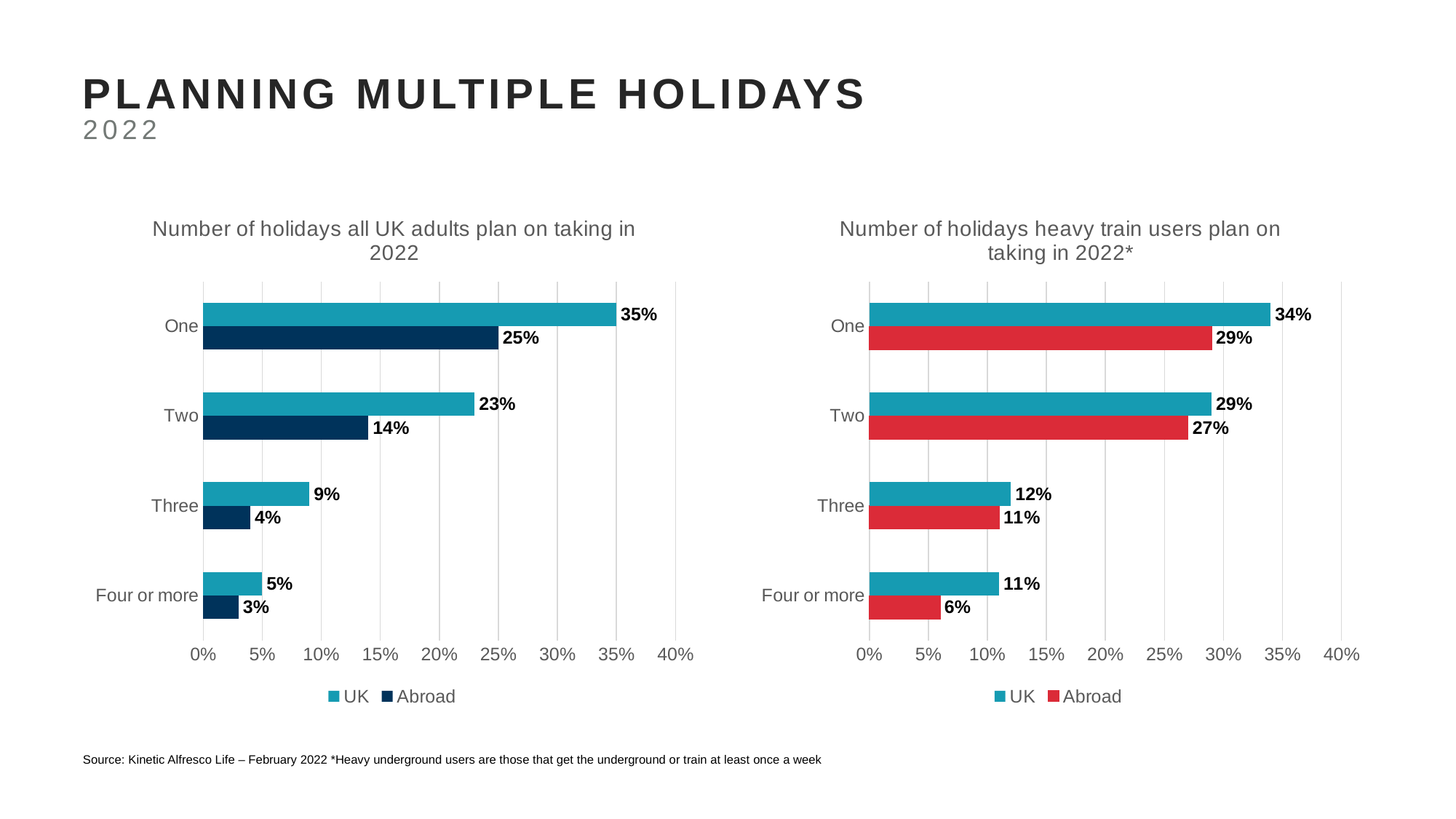
In the right chart (heavy train users), which category has the highest UK value? One In the left chart (all UK adults), what percentage plan on taking one holiday in the UK? 35% How many categories are shown on the left chart (all UK adults)? 4 In the right chart (heavy train users), what percentage plan on taking two holidays in the UK? 29% In the left chart (all UK adults), which category has the lowest Abroad value? Four or more In the right chart (heavy train users), what percentage plan on taking four or more holidays abroad? 6% In the left chart (all UK adults), what percentage plan on taking two holidays abroad? 14% What type of chart is the left chart (all UK adults)? Bar chart In the left chart (all UK adults), what is the difference between the UK and Abroad values for one holiday? 10% How many series does the legend of the right chart (heavy train users) list? 2 In the right chart (heavy train users), what is the difference between the UK and Abroad values for three holidays? 1% In the right chart (heavy train users), which is larger for two holidays: the UK value or the Abroad value? UK